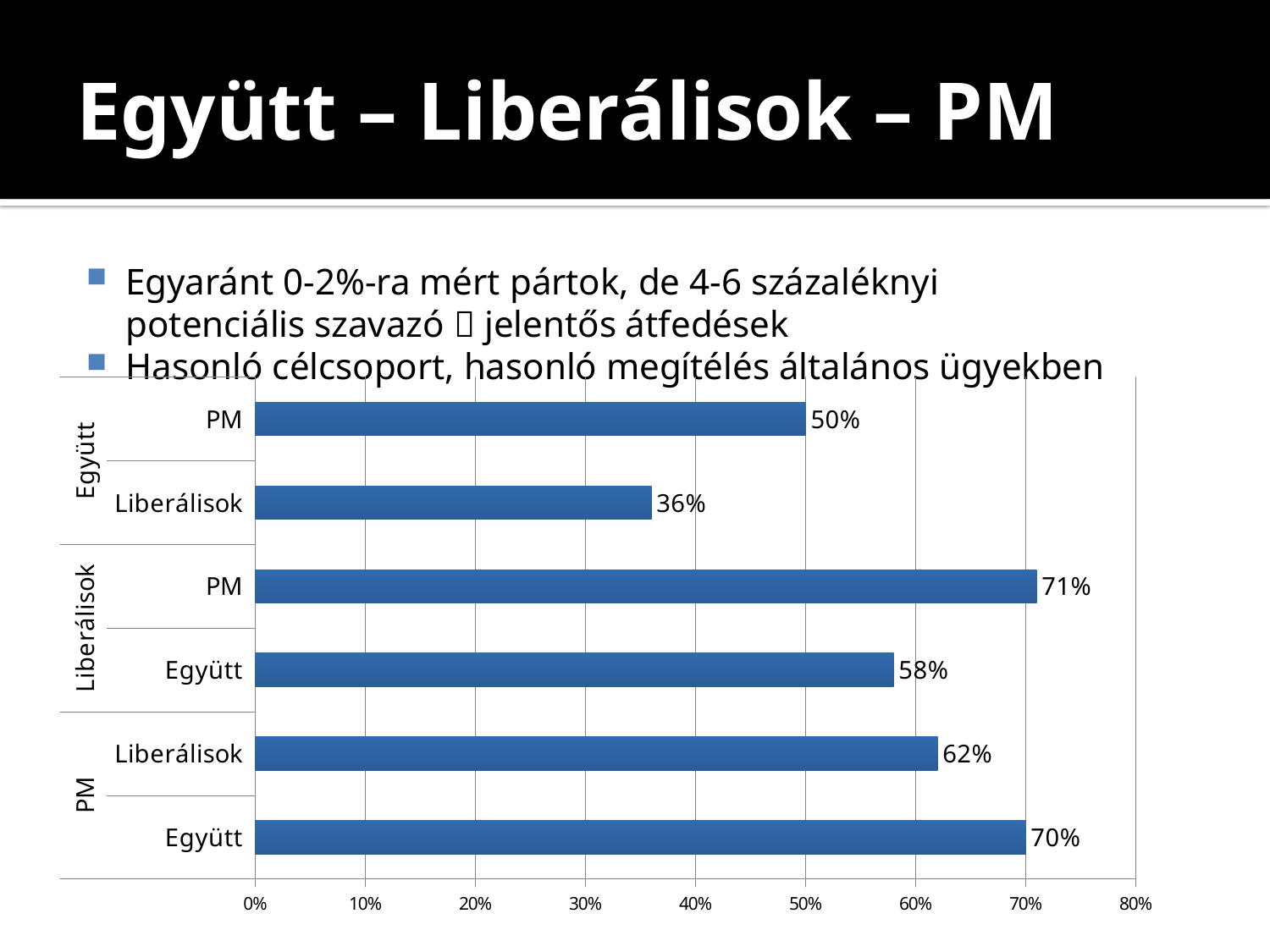
What is the difference between the PM value in the Liberálisok group and the Liberálisok value in the Együtt group? 35% In the PM group, what is the value for Liberálisok? 62% What kind of chart is shown on the slide? bar chart In the PM group, what is the value for Együtt? 70% How many bars are plotted in the chart? 6 Which bar has the highest value in the chart? PM in the Liberálisok group (71%) In the Együtt group, what is the value for PM? 50% In the Liberálisok group, what is the value for Együtt? 58% Which bar has the lowest value in the chart? Liberálisok in the Együtt group (36%) In the Liberálisok group, what is the value for PM? 71% In the Együtt group, what is the value for Liberálisok? 36% Which is larger: the Együtt value in the PM group or the Együtt value in the Liberálisok group? the Együtt value in the PM group (70%)